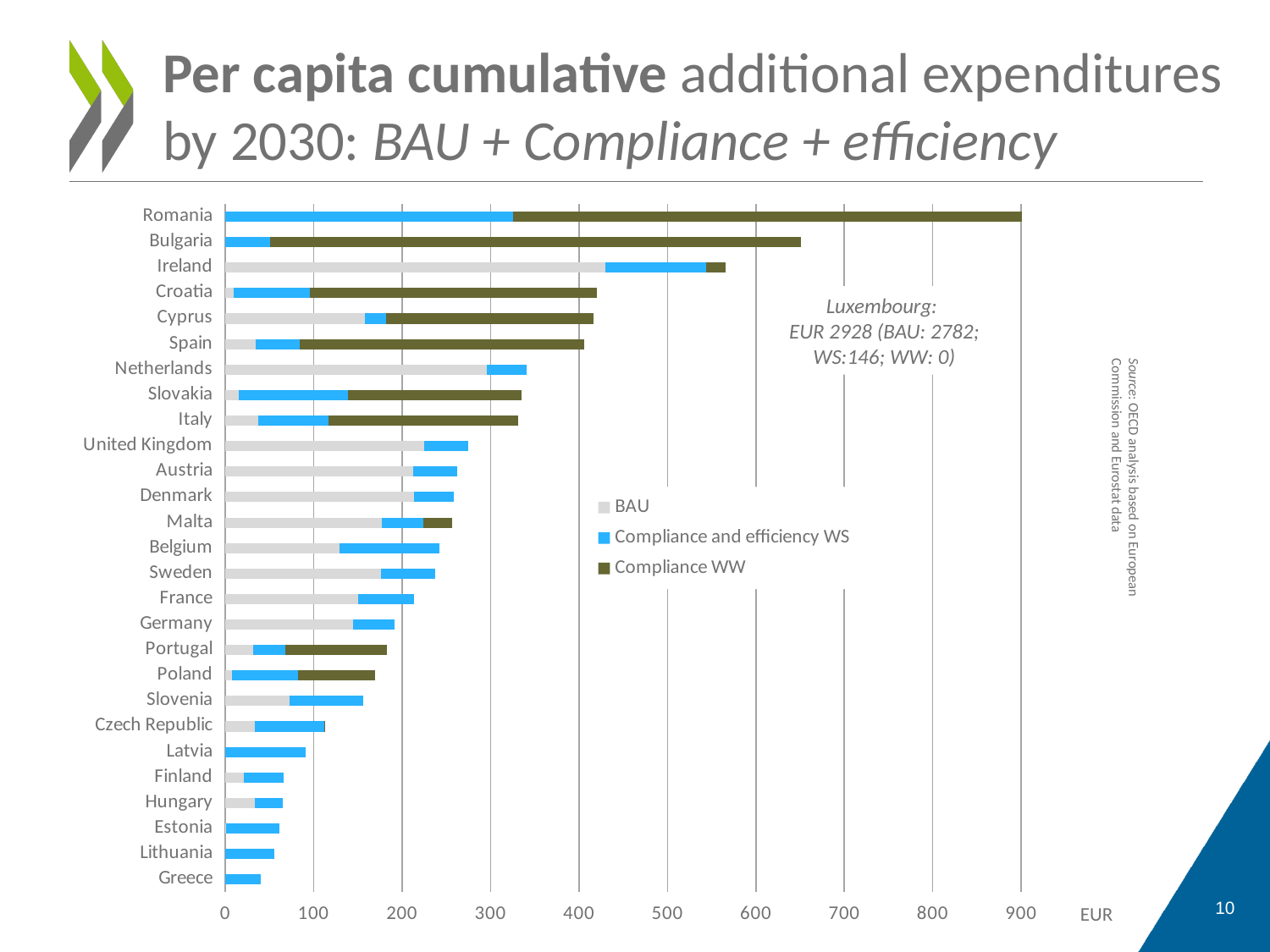
How many series does the chart legend list? 3 Which country has the lowest total per capita cumulative additional expenditure in the chart? Greece How many countries are listed on the vertical axis of the chart? 27 Is the total value for Greece greater or less than 100? less What are the three series named in the chart legend? BAU; Compliance and efficiency WS; Compliance WW According to the annotation on the chart, what is the total per capita cumulative additional expenditure for Luxembourg? EUR 2928 Which has the larger total expenditure, Ireland or Croatia? Ireland Which country has the highest total per capita cumulative additional expenditure in the chart? Romania Is the total value for Ireland greater or less than 500? greater Is the total value for Bulgaria greater or less than 600? greater What kind of chart is shown on the slide? Stacked bar chart